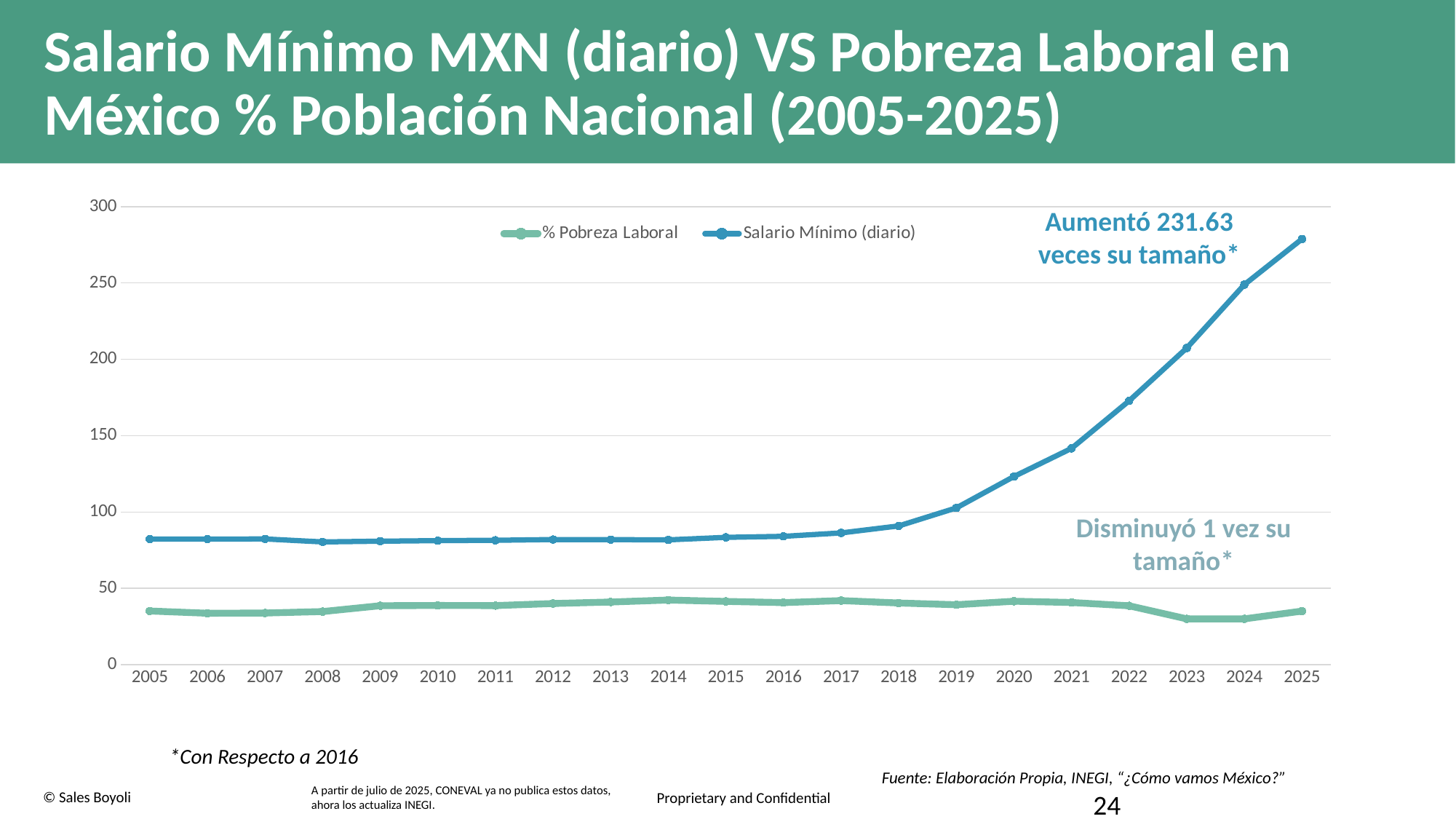
Does the Salario Mínimo (diario) line rise or fall from 2018 to 2025? Rise What colour is the Salario Mínimo (diario) line? Blue Is the value for Salario Mínimo (diario) in 2005 greater or less than 100? less What kind of chart is shown on the slide? Line chart How many series does the legend list? 2 Is the value for Salario Mínimo (diario) in 2025 greater or less than 250? greater Which series has the higher value in 2025, % Pobreza Laboral or Salario Mínimo (diario)? Salario Mínimo (diario) Is the value for % Pobreza Laboral in 2016 greater or less than 50? less How many years are plotted along the x axis? 21 Which year has the highest value for Salario Mínimo (diario)? 2025 According to the annotation on the chart, by how many times did the Salario Mínimo increase with respect to 2016? 231.63 veces